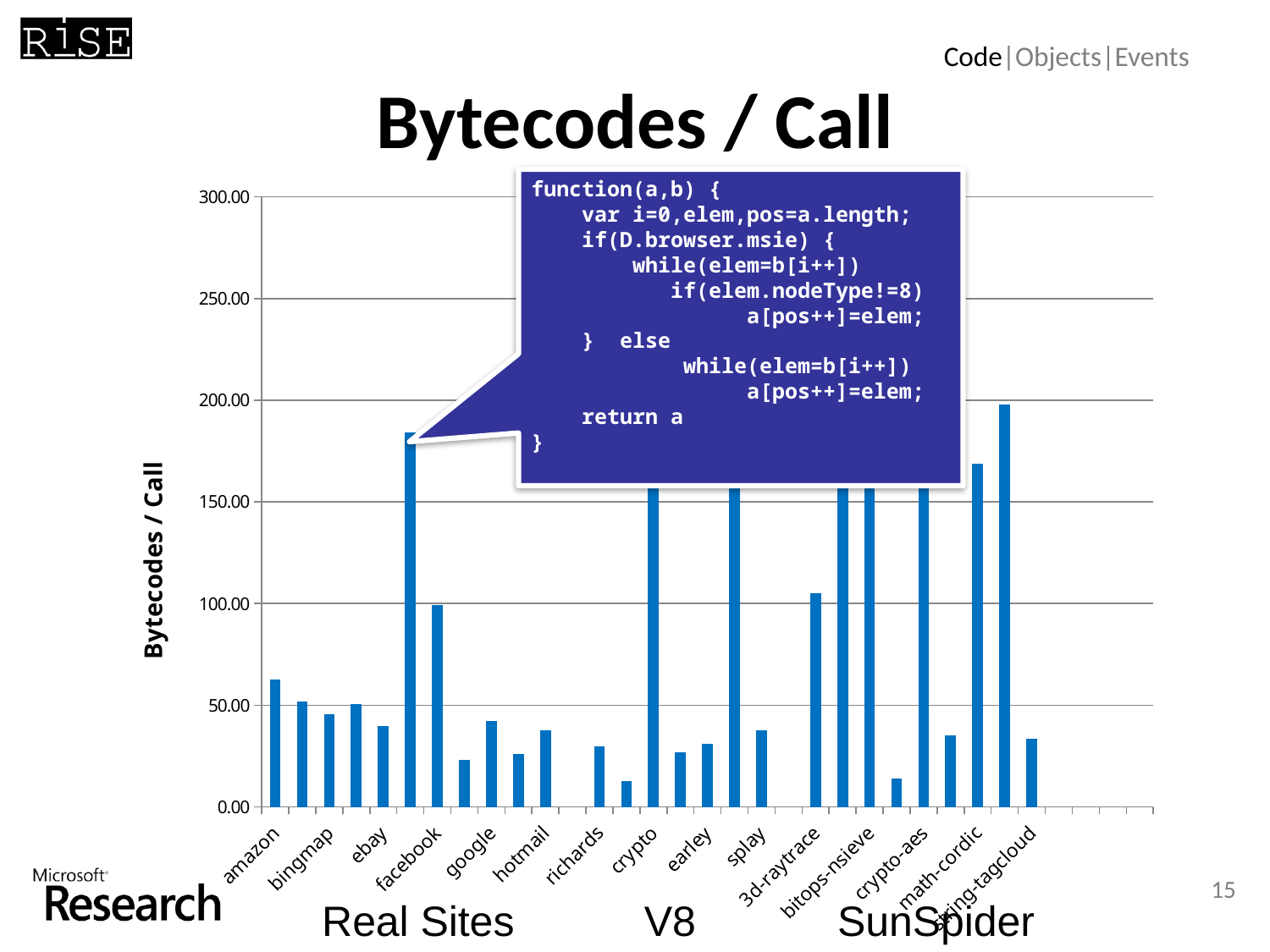
Is the value for 3d-raytrace greater or less than 100? greater Is the value for math-cordic greater or less than 150? greater Which has the larger value, crypto or richards? crypto What is the label on the vertical axis of the chart? Bytecodes / Call Is the value for google greater or less than 50? less Which has the larger value, amazon or google? amazon What kind of chart is shown on the slide? bar chart What is the title of the chart? Bytecodes / Call